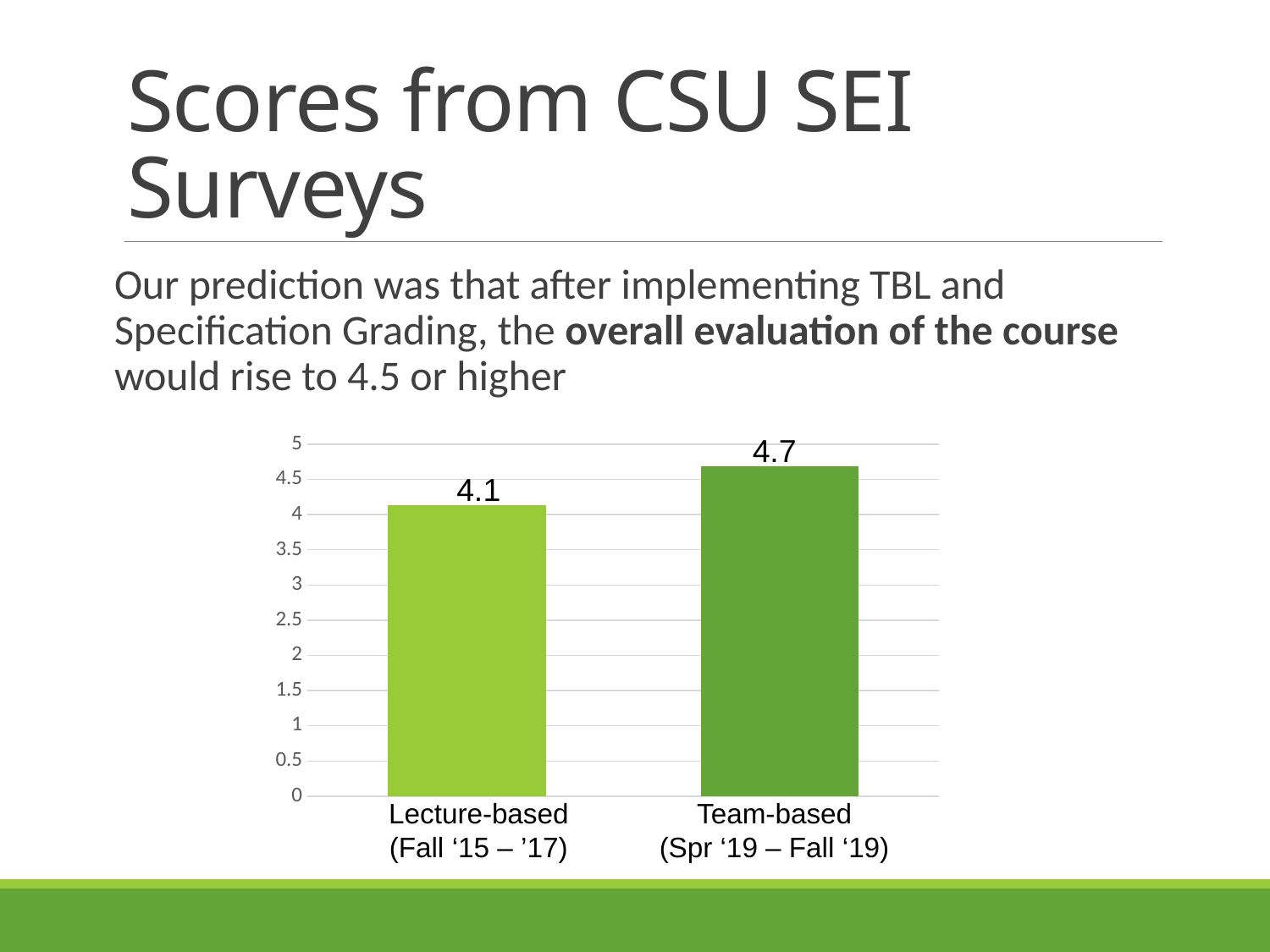
What is the value for Team-based (Spr '19 – Fall '19)? 4.7 Which category has the highest value? Team-based (Spr '19 – Fall '19) Which category has the lowest value? Lecture-based (Fall '15 – '17) What is the value for Lecture-based (Fall '15 – '17)? 4.1 Is the value for Team-based greater or less than 4.5? greater Do the values rise or fall from Lecture-based to Team-based? Rise Which is larger, the value for Lecture-based or the value for Team-based? Team-based What is the difference between the Team-based and Lecture-based values? 0.6 What is the maximum value shown on the vertical axis? 5 What kind of chart is shown on the slide? Bar chart Is the value for Lecture-based greater or less than 4.5? less How many categories are shown on the chart? 2